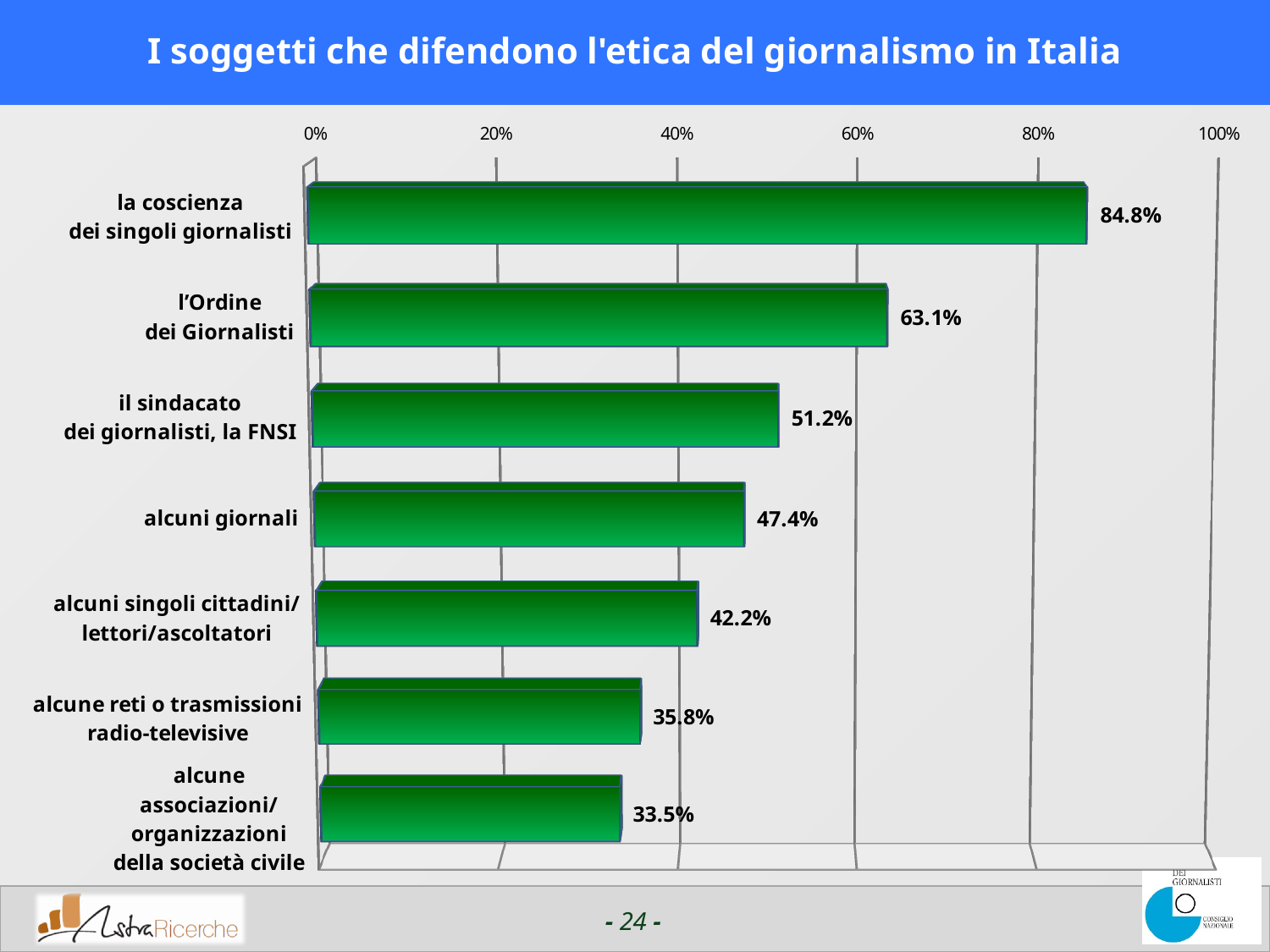
What kind of chart is shown on the slide? bar chart What is the value for "la coscienza dei singoli giornalisti"? 84.8% Which category has the highest value? la coscienza dei singoli giornalisti What is the title of the chart? I soggetti che difendono l'etica del giornalismo in Italia What is the value for "alcune reti o trasmissioni radio-televisive"? 35.8% How many categories are shown in the chart? 7 What is the value for "alcuni giornali"? 47.4% Which is larger: the value for "il sindacato dei giornalisti, la FNSI" or the value for "alcuni giornali"? il sindacato dei giornalisti, la FNSI What is the difference between the values for "la coscienza dei singoli giornalisti" and "l'Ordine dei Giornalisti"? 21.7% Is the value for "alcuni singoli cittadini/lettori/ascoltatori" greater or less than 40%? greater What is the value for "l'Ordine dei Giornalisti"? 63.1% Which category has the lowest value? alcune associazioni/organizzazioni della società civile